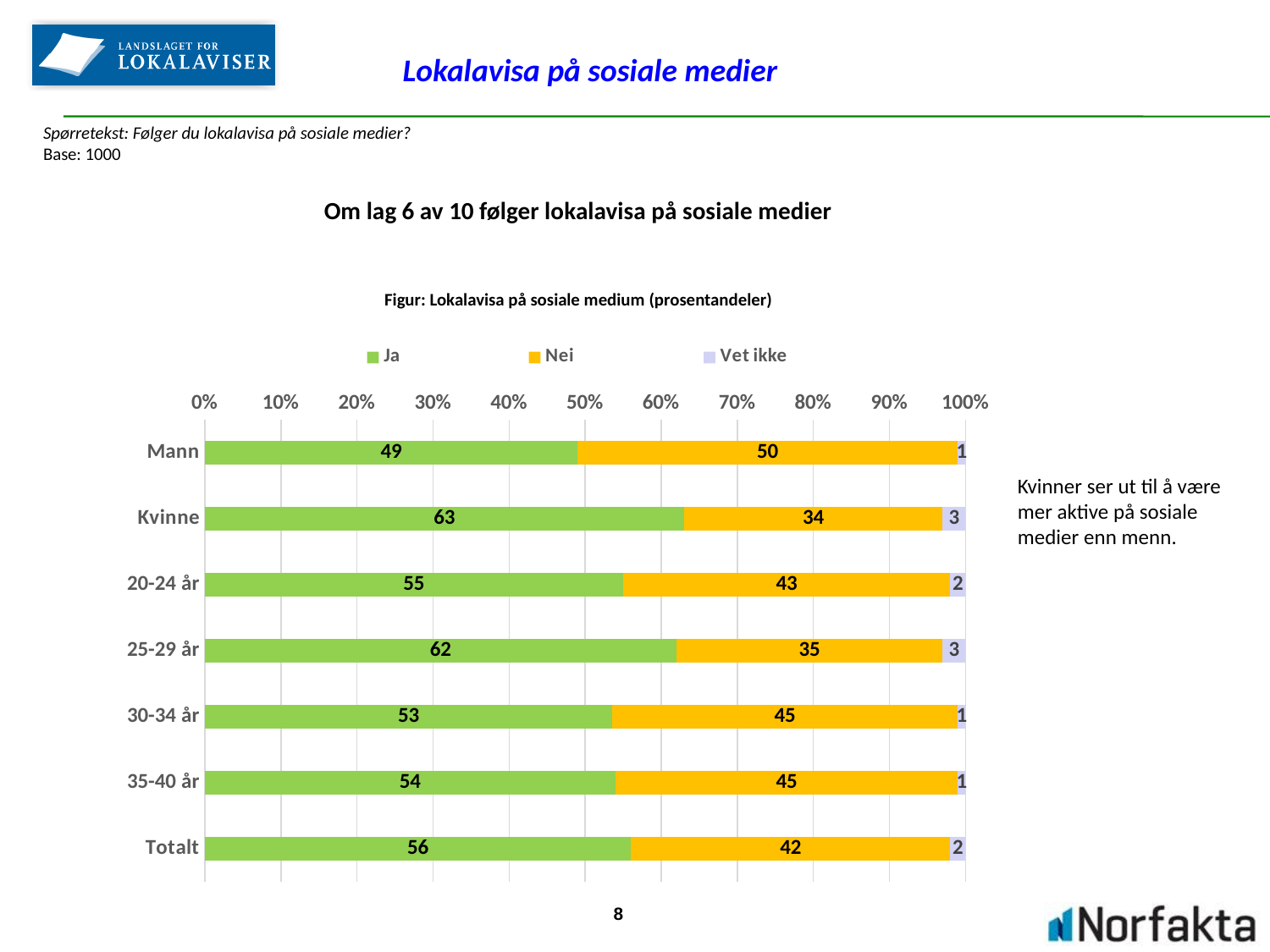
What is the 'Ja' value for Kvinne? 63 What kind of chart is shown? Stacked bar chart Which is larger, the 'Nei' value for 20-24 år or for 25-29 år? 20-24 år What is the title of the figure? Figur: Lokalavisa på sosiale medium (prosentandeler) How many series does the legend list? 3 Which category has the lowest 'Ja' value? Mann What is the 'Nei' value for Mann? 50 What is the difference between the 'Ja' values for Kvinne and Mann? 14 What is the 'Vet ikke' value for 25-29 år? 3 What is the 'Ja' value for Totalt? 56 Which category has the highest 'Ja' value? Kvinne How many categories are shown on the chart? 7